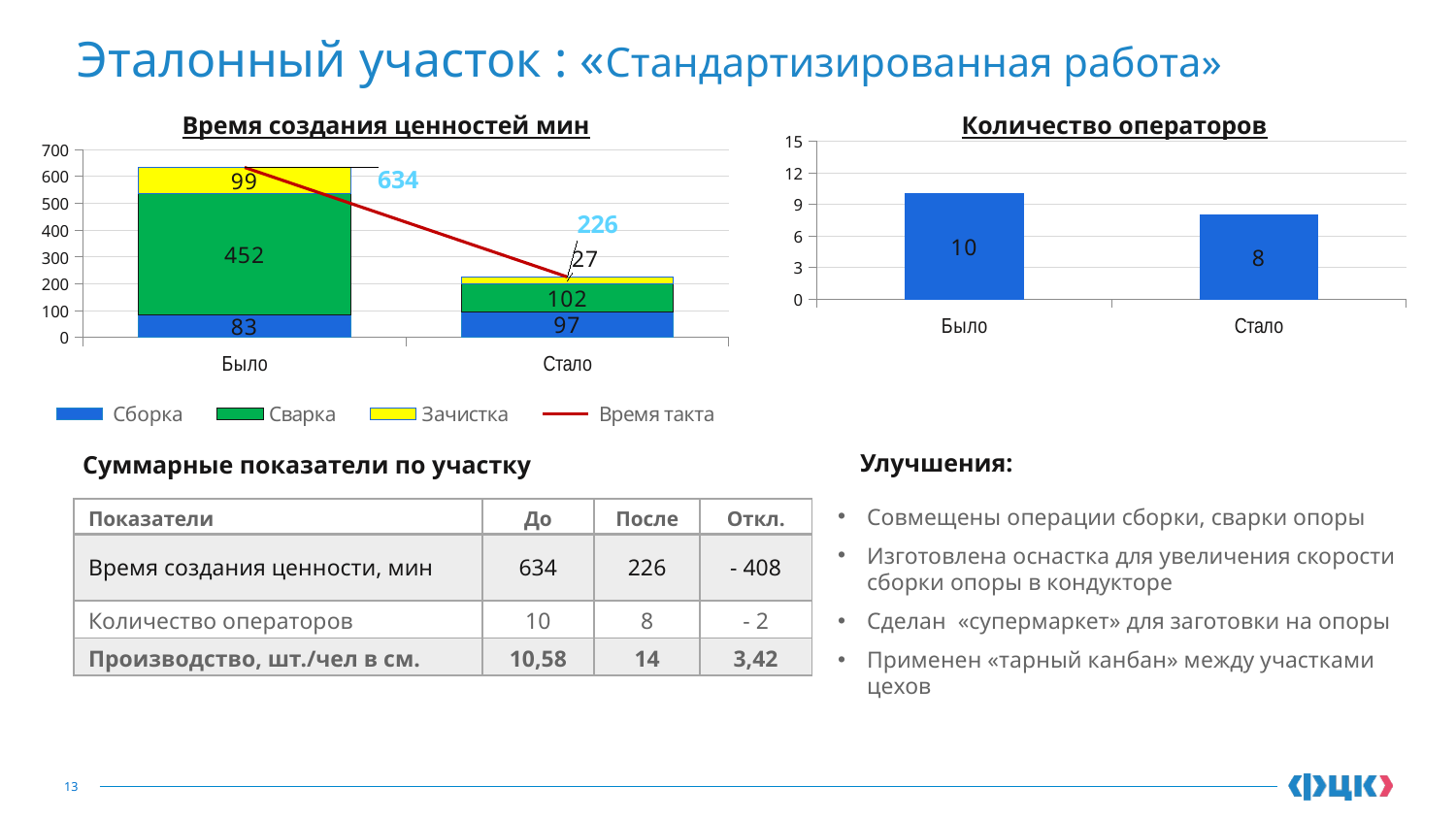
What kind of chart is 'Количество операторов'? Bar chart In the chart 'Время создания ценностей мин', what is the value of Сварка for Было? 452 In the chart 'Время создания ценностей мин', what is the value of Сборка for Стало? 97 In the chart 'Время создания ценностей мин', what is the value of Зачистка for Было? 99 In the chart 'Время создания ценностей мин', what is the total of the stacked bar for Было? 634 In the chart 'Количество операторов', which category has the lowest value? Стало In the chart 'Время создания ценностей мин', how many series does the legend list? 4 In the chart 'Время создания ценностей мин', what is the total of the stacked bar for Стало? 226 In the chart 'Время создания ценностей мин', which is larger: Зачистка for Было or Зачистка for Стало? Зачистка for Было In the chart 'Количество операторов', what is the value for Было? 10 In the chart 'Время создания ценностей мин', what is the difference between Сварка for Было and Сварка for Стало? 350 In the chart 'Количество операторов', what is the difference between Было and Стало? 2